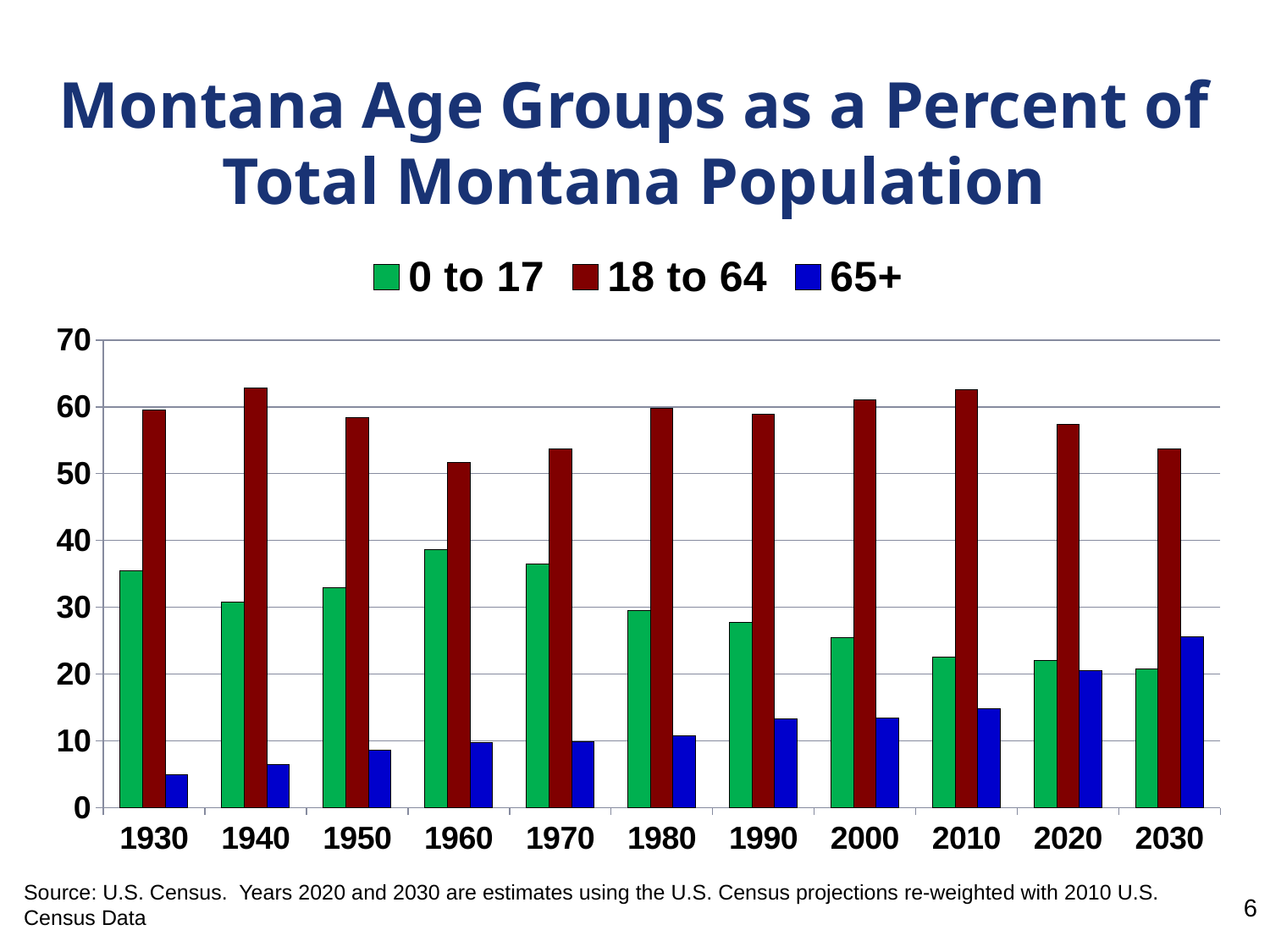
What kind of chart is shown on the slide? bar chart Is the value for 0 to 17 in 1930 greater or less than 30? greater How many years are shown along the x axis? 11 Does the 65+ series rise or fall from 1930 to 2030? rises Which year has the lowest value for the 65+ series? 1930 Which year has the highest value for the 0 to 17 series? 1960 Is the value for 65+ in 2030 greater or less than 20? greater Is the value for 18 to 64 in 1960 greater or less than 60? less Which year has the highest value for the 65+ series? 2030 How many series does the legend list? 3 What colour are the bars for the 18 to 64 series? dark red Which is larger: the 18 to 64 value in 2000 or the 18 to 64 value in 2020? 2000